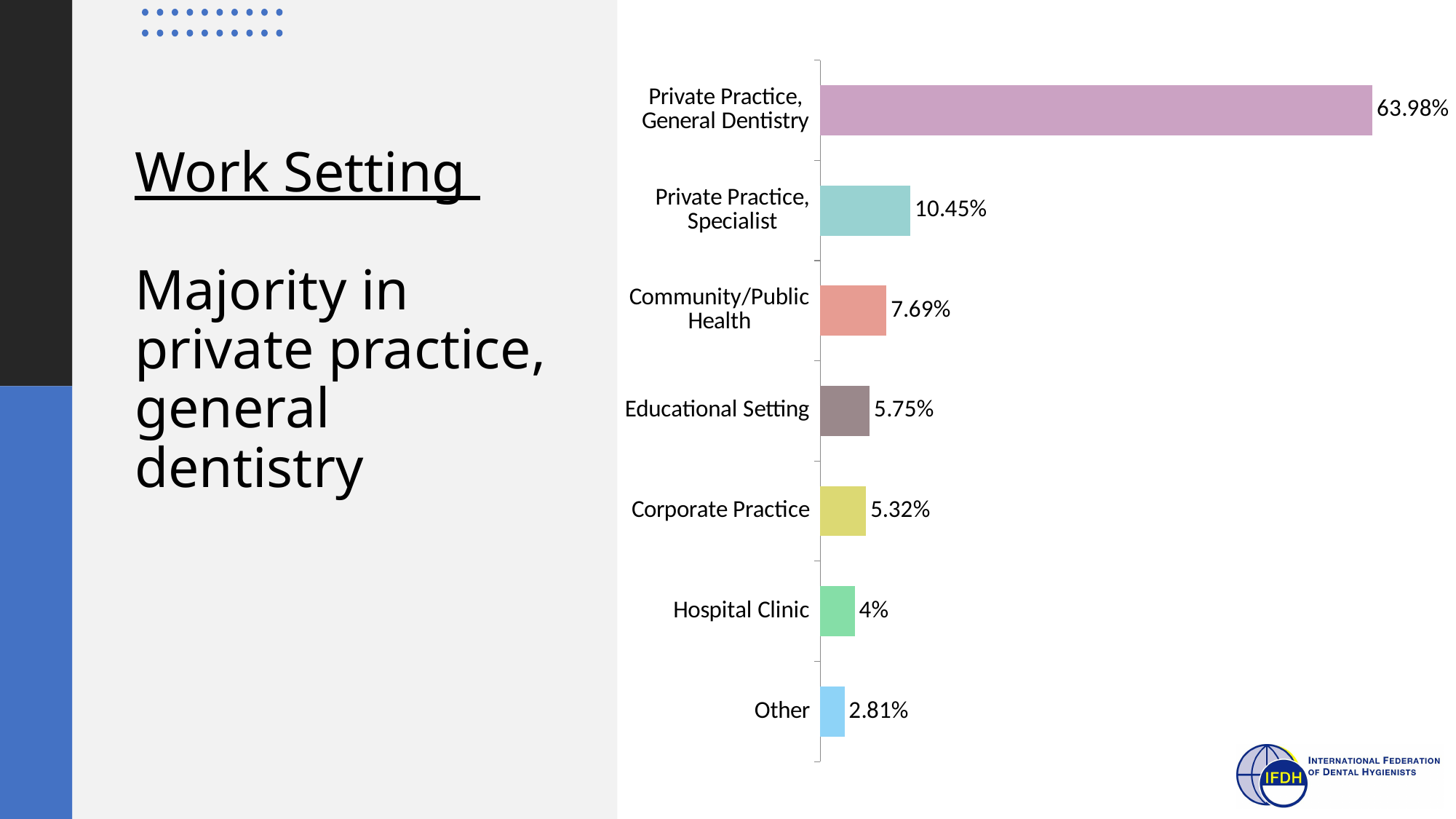
Which is larger, Community/Public Health or Educational Setting? Community/Public Health What type of chart is shown on the slide? Bar chart What is the title of the slide? Work Setting Which work setting has the highest value? Private Practice, General Dentistry What is the difference between Corporate Practice and Hospital Clinic? 1.32% What is the value shown for Educational Setting? 5.75% What percentage of respondents work in Private Practice, General Dentistry? 63.98% Which work setting has the lowest value? Other What is the difference between Private Practice, General Dentistry and Private Practice, Specialist? 53.53% What is the value shown for Community/Public Health? 7.69% What is the value shown for Hospital Clinic? 4% How many work setting categories are shown in the chart? 7